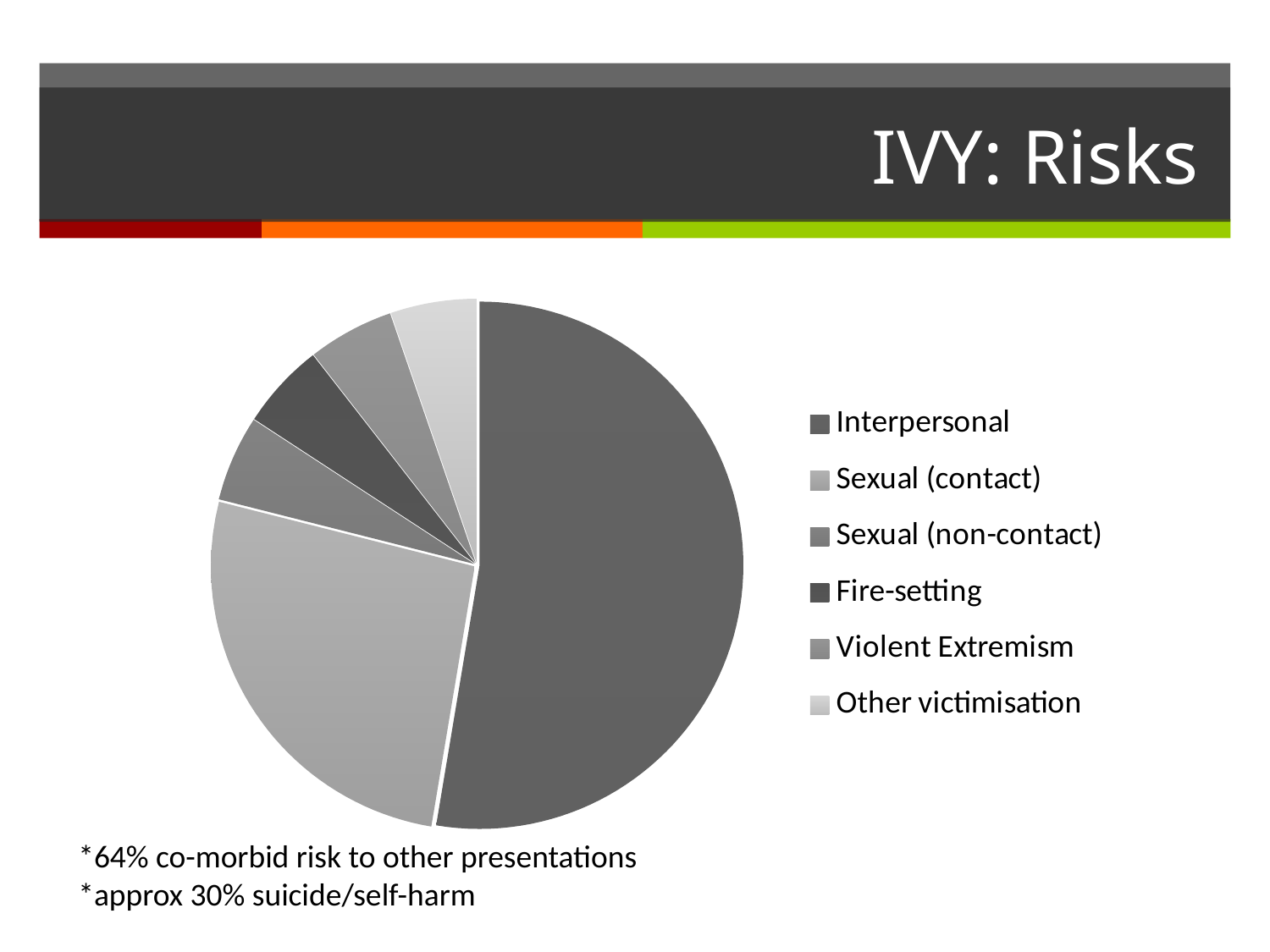
Which category has the largest slice of the pie chart? Interpersonal Which is larger in the pie chart, Sexual (contact) or Sexual (non-contact)? Sexual (contact) Which category is listed first in the pie chart's legend? Interpersonal Which is larger in the pie chart, Sexual (contact) or Fire-setting? Sexual (contact) Is the share of the pie for Fire-setting greater or less than 25%? less Which is larger in the pie chart, Interpersonal or Sexual (contact)? Interpersonal Is the share of the pie for Interpersonal greater or less than 25%? greater What kind of chart is shown on the slide? pie chart How many categories does the pie chart show? 6 Is the share of the pie for Sexual (contact) greater or less than 10%? greater What is the title of the slide containing the pie chart? IVY: Risks How many entries does the legend of the pie chart list? 6